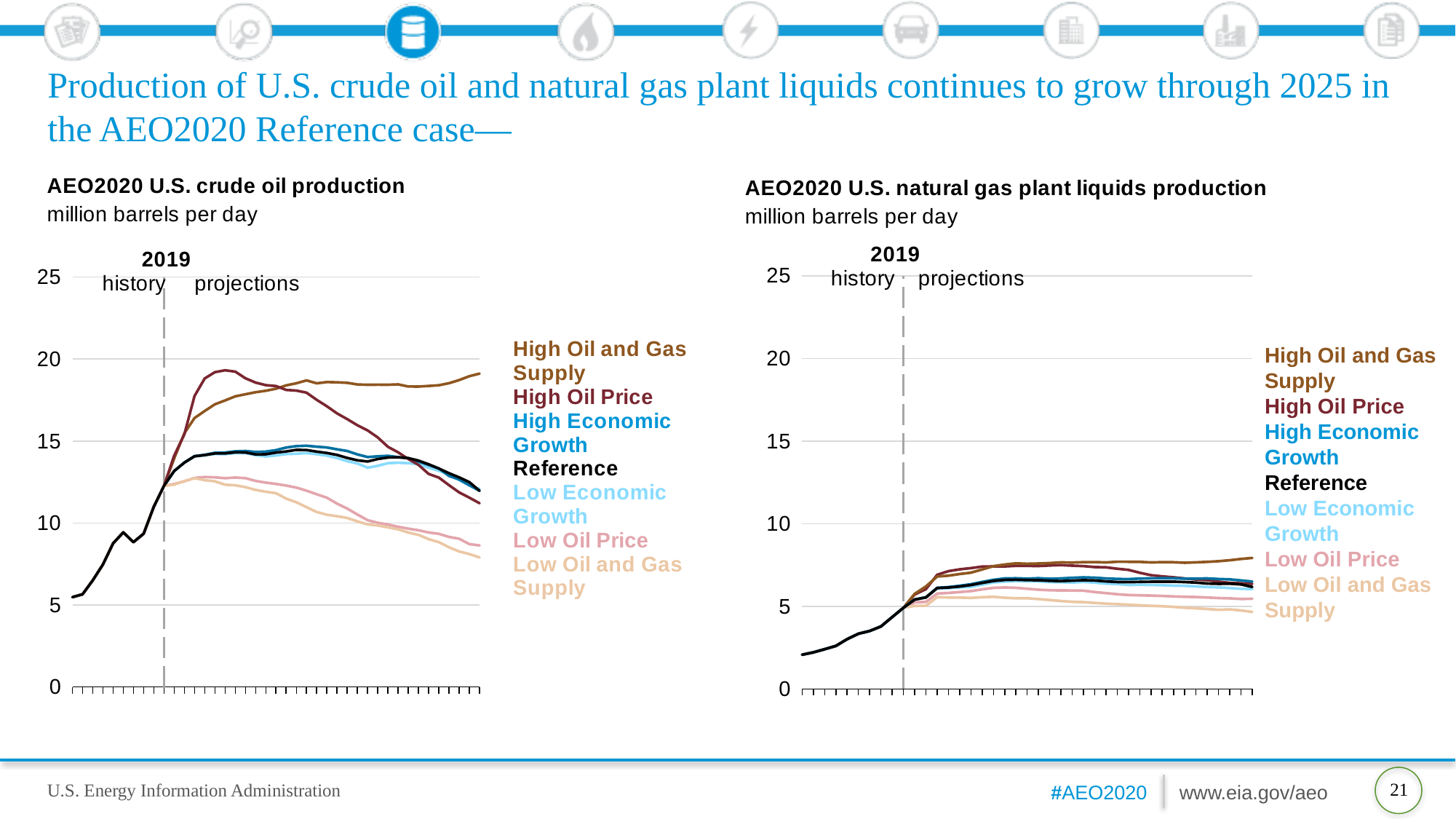
In the AEO2020 U.S. crude oil production chart, is the Reference value at the end of the projection period greater or less than 15? less In the AEO2020 U.S. natural gas plant liquids production chart, is the Reference value at the end of the projection period greater or less than 10? less In the AEO2020 U.S. crude oil production chart, which series is highest at the end of the projection period? High Oil and Gas Supply In the AEO2020 U.S. natural gas plant liquids production chart, which series is highest at the end of the projection period? High Oil and Gas Supply How many series does the legend of the AEO2020 U.S. crude oil production chart list? 7 What unit is used on the y axis of the AEO2020 U.S. natural gas plant liquids production chart? million barrels per day In the AEO2020 U.S. crude oil production chart, which series is lowest at the end of the projection period? Low Oil and Gas Supply What kind of chart is the AEO2020 U.S. crude oil production chart? line chart In the AEO2020 U.S. natural gas plant liquids production chart, which series is lowest at the end of the projection period? Low Oil and Gas Supply In the AEO2020 U.S. crude oil production chart, which is larger at the end of the projection period, High Oil Price or Low Oil Price? High Oil Price In the AEO2020 U.S. crude oil production chart, is the High Oil and Gas Supply value at the end of the projection period greater or less than 15? greater How many series does the legend of the AEO2020 U.S. natural gas plant liquids production chart list? 7